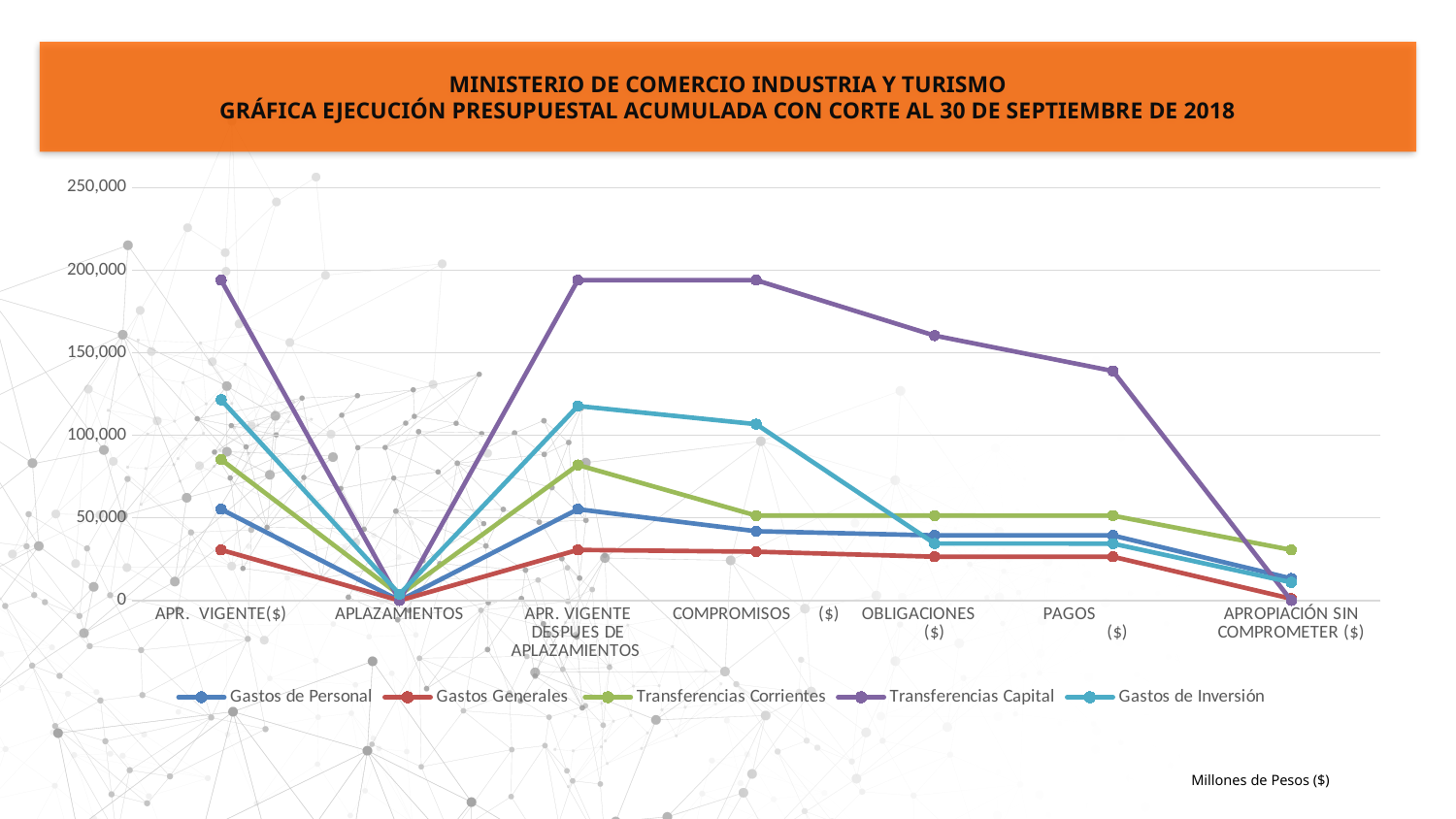
Is the value for Transferencias Capital at APR. VIGENTE greater or less than 150,000? greater Which series has the lowest value at APR. VIGENTE? Gastos Generales At APR. VIGENTE, which is larger: Gastos de Inversión or Transferencias Corrientes? Gastos de Inversión At PAGOS, which is larger: Transferencias Corrientes or Gastos de Personal? Transferencias Corrientes How many series does the legend list? 5 What kind of chart is shown on the slide? Line chart Does the Transferencias Capital line rise or fall from COMPROMISOS to APROPIACIÓN SIN COMPROMETER? Fall What unit is stated below the chart for the values? Millones de Pesos ($) Is the value for Gastos Generales at APR. VIGENTE greater or less than 50,000? less Which series has the highest value at COMPROMISOS? Transferencias Capital How many categories are shown along the x axis? 7 Is the value for Gastos de Inversión at APR. VIGENTE DESPUES DE APLAZAMIENTOS greater or less than 100,000? greater